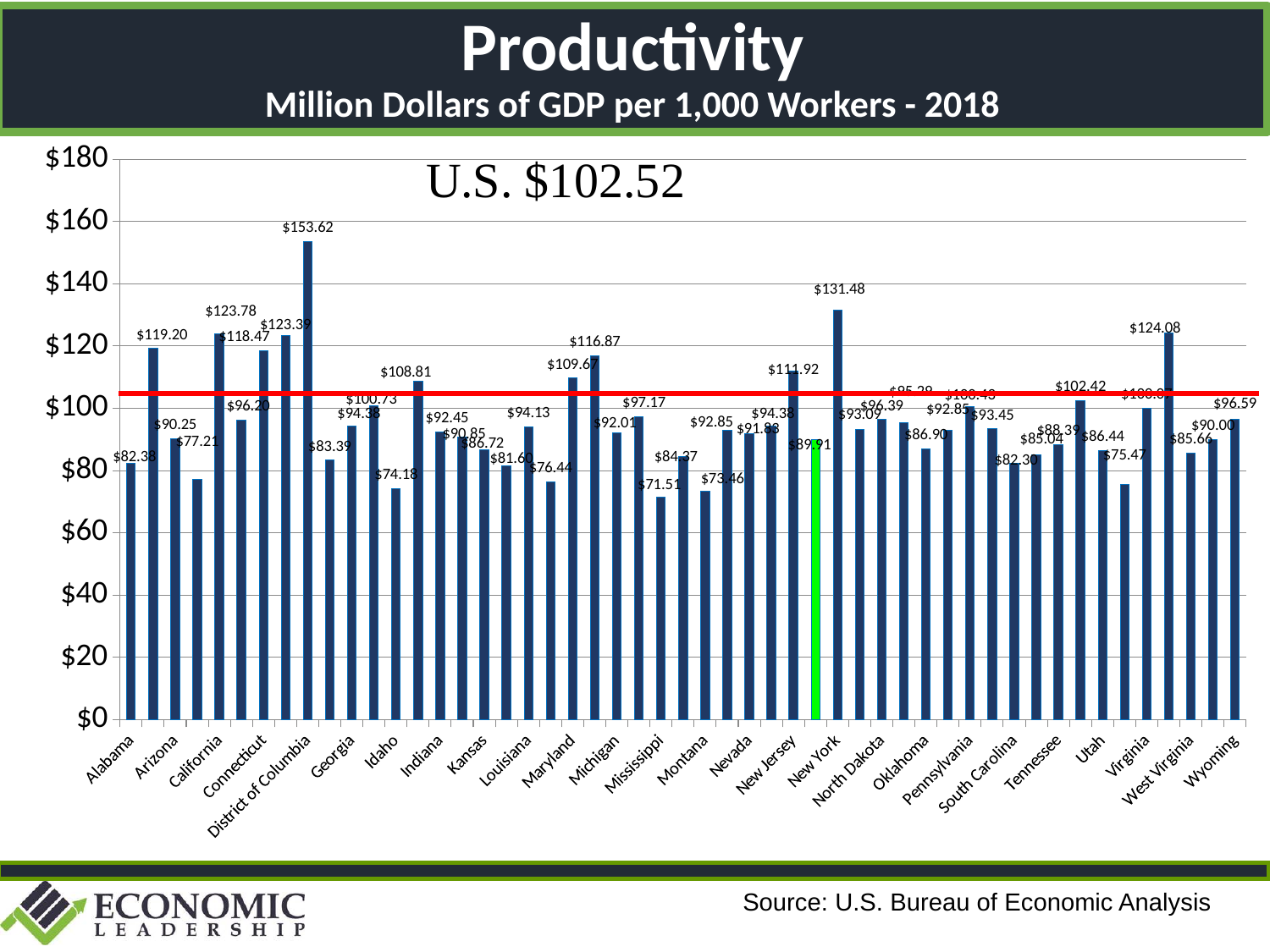
Which category has the lowest value? Mississippi What is the value for Wyoming? $96.59 Which is larger, the value for California or the value for Connecticut? California What is the value for Mississippi? $71.51 What is the value for District of Columbia? $153.62 Which category has the highest value? District of Columbia What is the difference between the values for District of Columbia and Alabama? $71.24 What is the value for New York? $131.48 What U.S. value is printed on the chart? $102.52 What is the difference between the values for New York and New Jersey? $19.56 What kind of chart is shown on the slide? bar chart Is the value for Idaho greater or less than $80? less